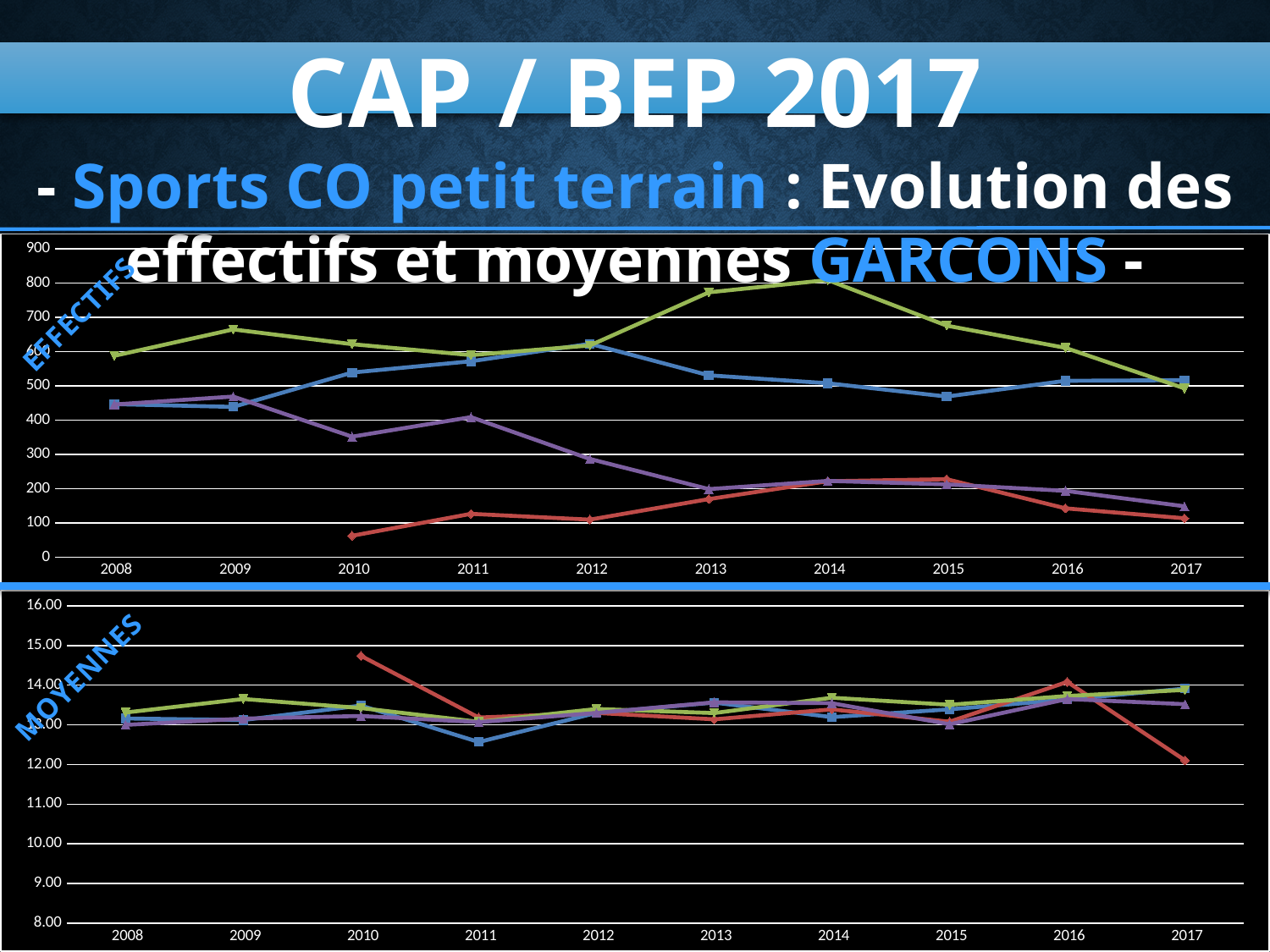
In the top chart (EFFECTIFS), is the value of the purple line in 2017 greater or less than 200? less In the bottom chart (MOYENNES), is the value of the red line in 2017 greater or less than 13.00? less In the top chart (EFFECTIFS), is the value of the red line in 2010 greater or less than 100? less In the top chart (EFFECTIFS), does the purple line rise or fall overall from 2008 to 2017? Fall How many years are shown on the x axis of the top chart (EFFECTIFS)? 10 What kind of chart is the top chart (EFFECTIFS)? Line chart In the top chart (EFFECTIFS), in which year does the green line reach its highest value? 2014 What kind of chart is the bottom chart (MOYENNES)? Line chart What is the highest value shown on the y axis of the top chart (EFFECTIFS)? 900 How many years are shown on the x axis of the bottom chart (MOYENNES)? 10